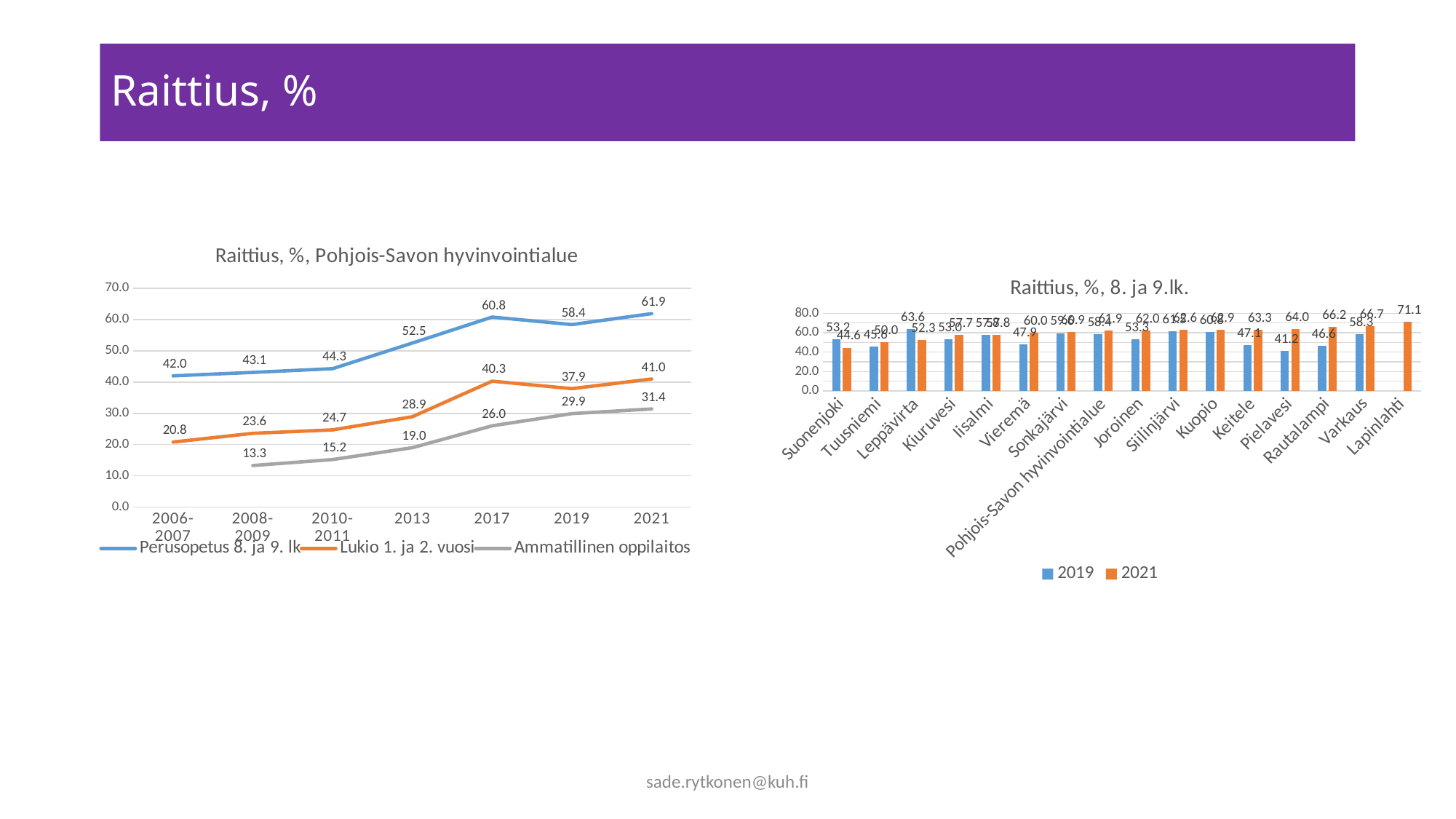
In the left chart 'Raittius, %, Pohjois-Savon hyvinvointialue', in which period is the Lukio 1. ja 2. vuosi value highest? 2021 In the left chart 'Raittius, %, Pohjois-Savon hyvinvointialue', what is the value for Perusopetus 8. ja 9. lk in 2021? 61.9 In the left chart 'Raittius, %, Pohjois-Savon hyvinvointialue', does the Ammatillinen oppilaitos series rise or fall over time? Rise In the left chart 'Raittius, %, Pohjois-Savon hyvinvointialue', what is the value for Lukio 1. ja 2. vuosi in 2017? 40.3 In the right chart 'Raittius, %, 8. ja 9.lk.', what is the 2021 value for Lapinlahti? 71.1 In the left chart 'Raittius, %, Pohjois-Savon hyvinvointialue', what is the difference between Perusopetus 8. ja 9. lk and Lukio 1. ja 2. vuosi in 2021? 20.9 What kind of chart is the right chart titled 'Raittius, %, 8. ja 9.lk.'? Bar chart In the right chart 'Raittius, %, 8. ja 9.lk.', which category has the highest 2021 value? Lapinlahti What kind of chart is the left chart titled 'Raittius, %, Pohjois-Savon hyvinvointialue'? Line chart How many categories are shown on the x axis of the right chart 'Raittius, %, 8. ja 9.lk.'? 16 In the right chart 'Raittius, %, 8. ja 9.lk.', what is the difference between the 2021 and 2019 values for Pielavesi? 22.8 How many series does the legend of the left chart 'Raittius, %, Pohjois-Savon hyvinvointialue' list? 3